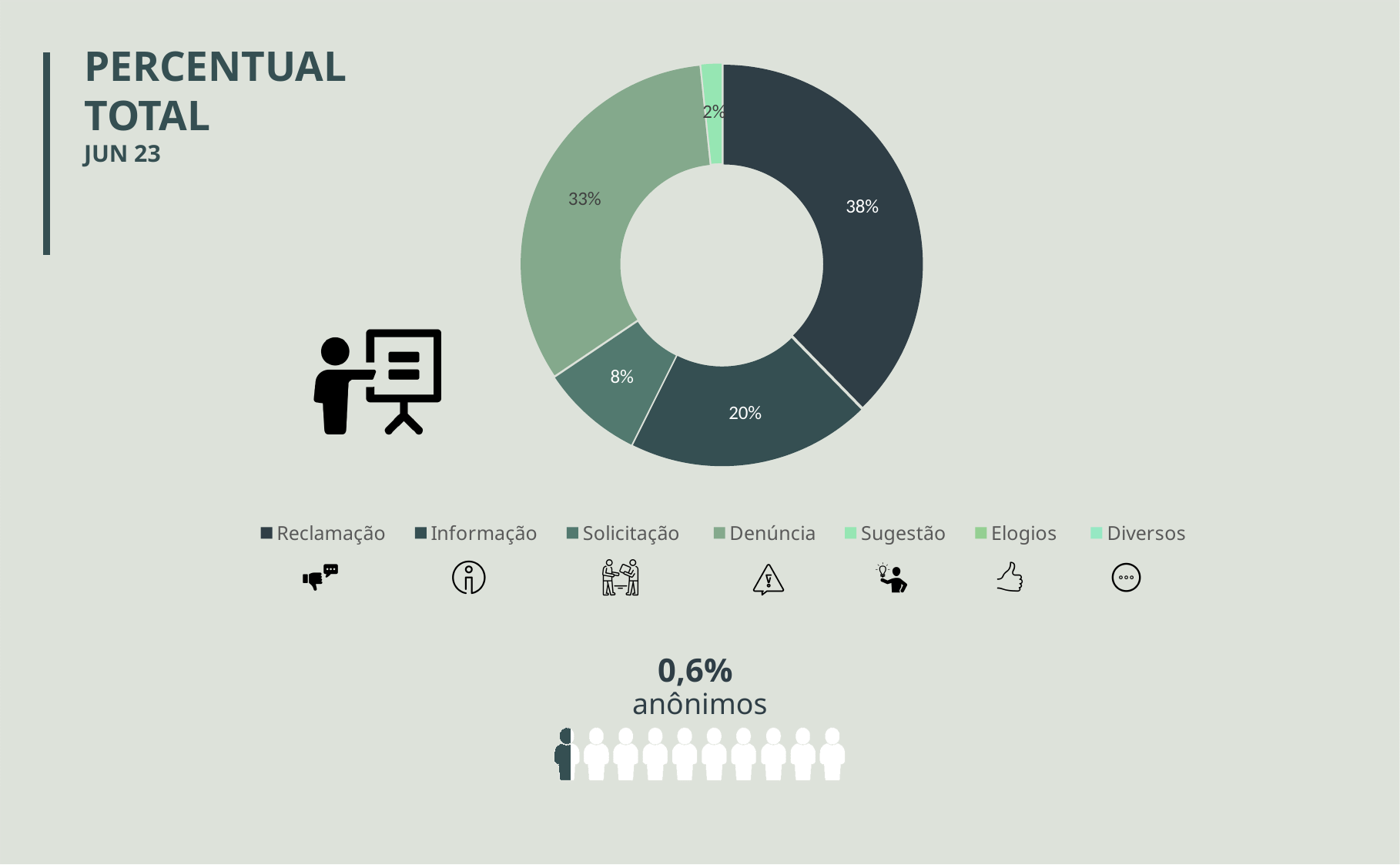
What percentage does the Solicitação slice show? 8% How many categories does the legend list? 7 What is the difference in percentage points between the Reclamação and Denúncia slices? 5% What is the difference in percentage points between the Informação and Solicitação slices? 12% Which slice is larger, Informação or Solicitação? Informação What percentage does the Informação slice show? 20% What percentage does the Denúncia slice show? 33% What percentage does the Reclamação slice show? 38% What is the title of the chart on the slide? PERCENTUAL TOTAL What is the smallest percentage labelled on the pie chart? 2% Which category has the largest slice of the pie? Reclamação What kind of chart is shown on the slide? doughnut chart